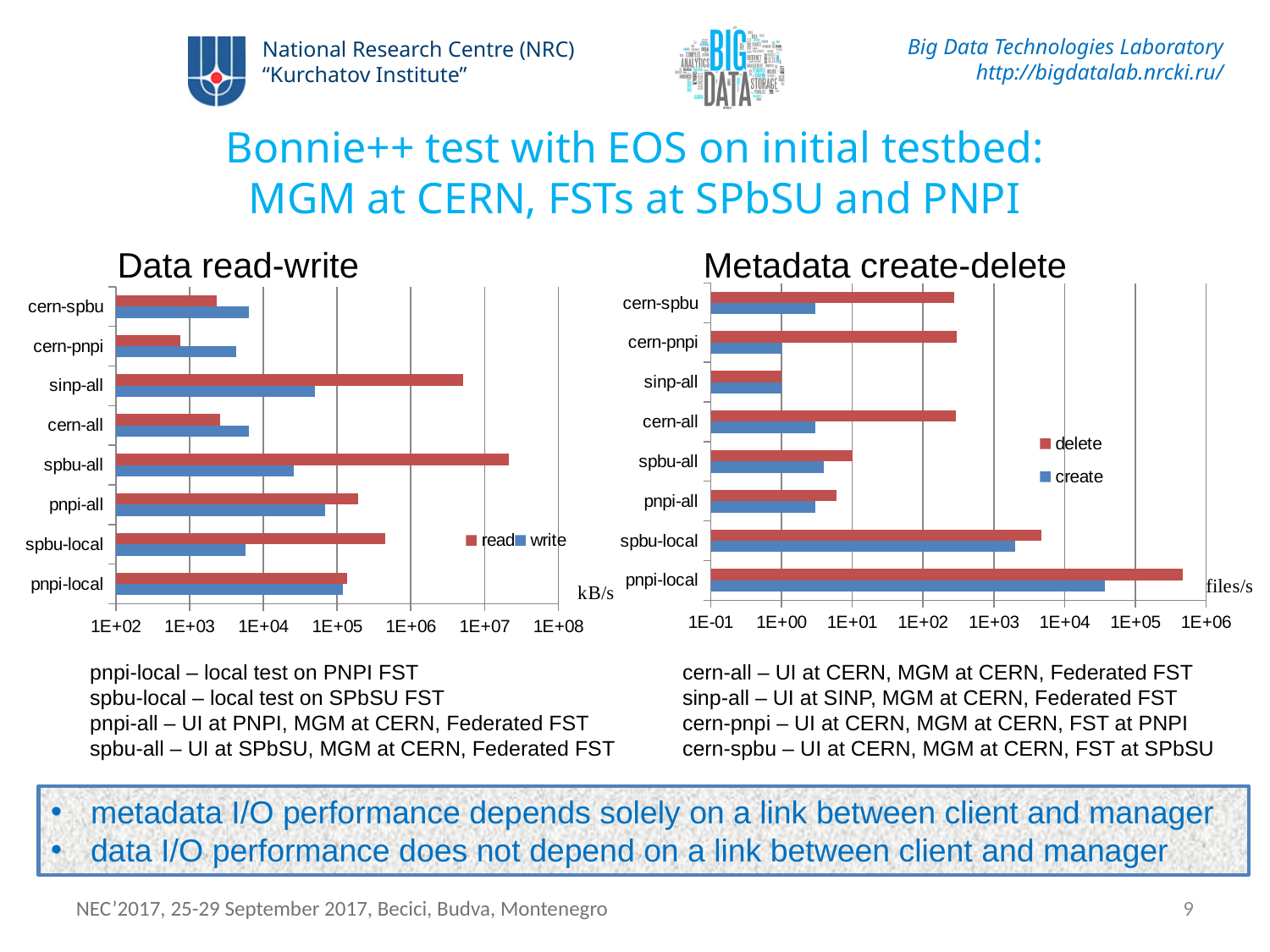
In the "Metadata create-delete" chart, which category has the lowest delete value? sinp-all How many series does the legend of the "Data read-write" chart list? 2 What kind of chart is the "Data read-write" chart? bar chart How many categories are shown on the "Metadata create-delete" chart? 8 In the "Data read-write" chart, which category has the lowest read value? cern-pnpi In the "Data read-write" chart, which is larger for spbu-all, read or write? read In the "Data read-write" chart, is the read value for cern-pnpi greater or less than 1E+04? less In the "Data read-write" chart, which category has the highest read value? spbu-all What unit is shown at the end of the x axis of the "Metadata create-delete" chart? files/s In the "Metadata create-delete" chart, which category has the highest delete value? pnpi-local In the "Data read-write" chart, is the read value for sinp-all greater or less than 1E+06? greater In the "Metadata create-delete" chart, is the delete value for pnpi-local greater or less than 1E+05? greater